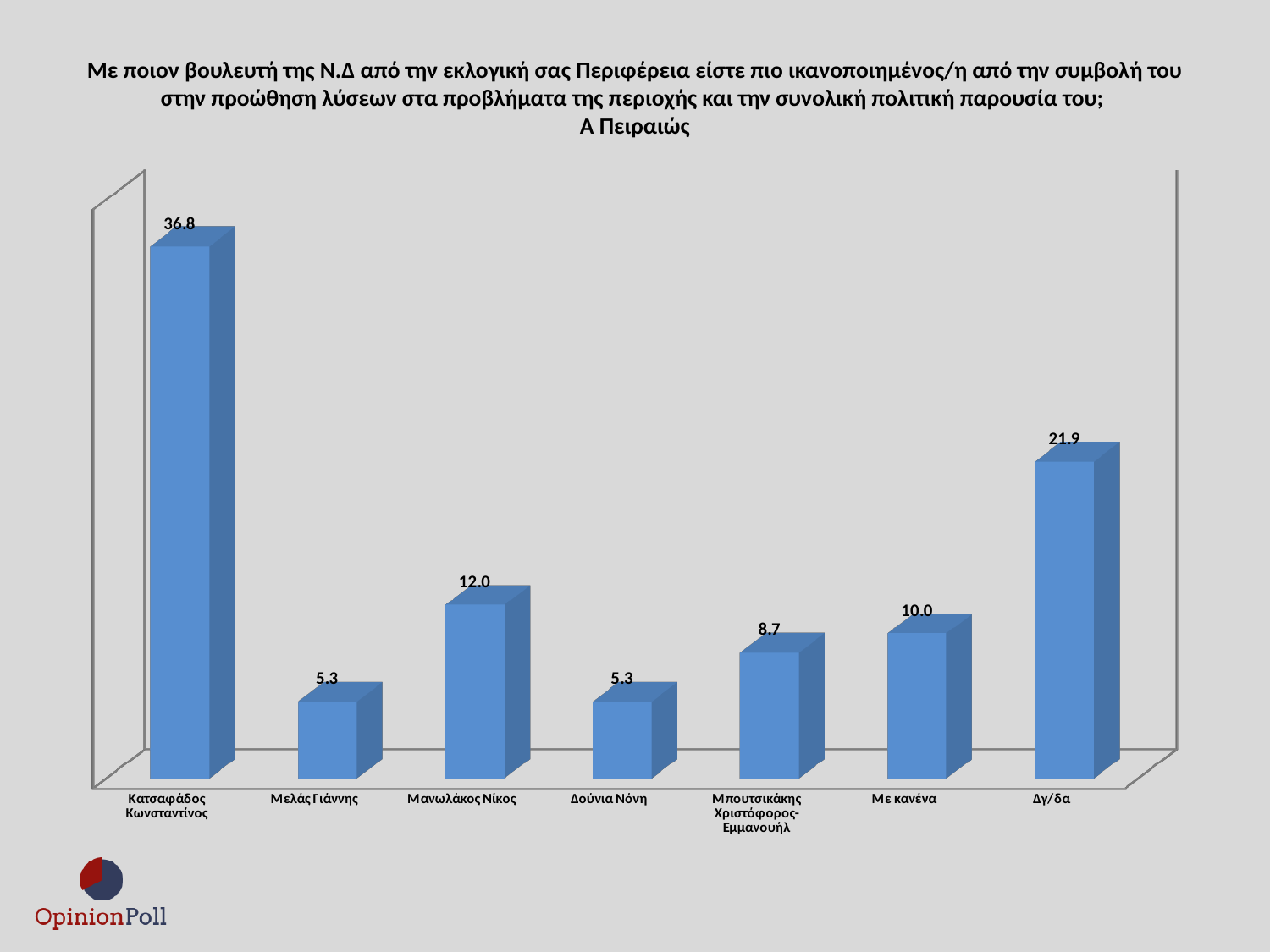
What is the difference between the values for Μανωλάκος Νίκος and Μελάς Γιάννης? 6.7 What is the value for Δγ/δα? 21.9 What is the difference between the values for Κατσαφάδος Κωνσταντίνος and Δγ/δα? 14.9 What is the value for Μπουτσικάκης Χριστόφορος-Εμμανουήλ? 8.7 Which is larger, the value for Με κανένα or the value for Μπουτσικάκης Χριστόφορος-Εμμανουήλ? Με κανένα Which two categories share the same value of 5.3? Μελάς Γιάννης and Δούνια Νόνη What is the value for Μανωλάκος Νίκος? 12.0 How many categories are shown on the chart? 7 What is the value for Κατσαφάδος Κωνσταντίνος? 36.8 What is the value for Με κανένα? 10.0 What kind of chart is shown on the slide? Bar chart Which category has the highest value? Κατσαφάδος Κωνσταντίνος